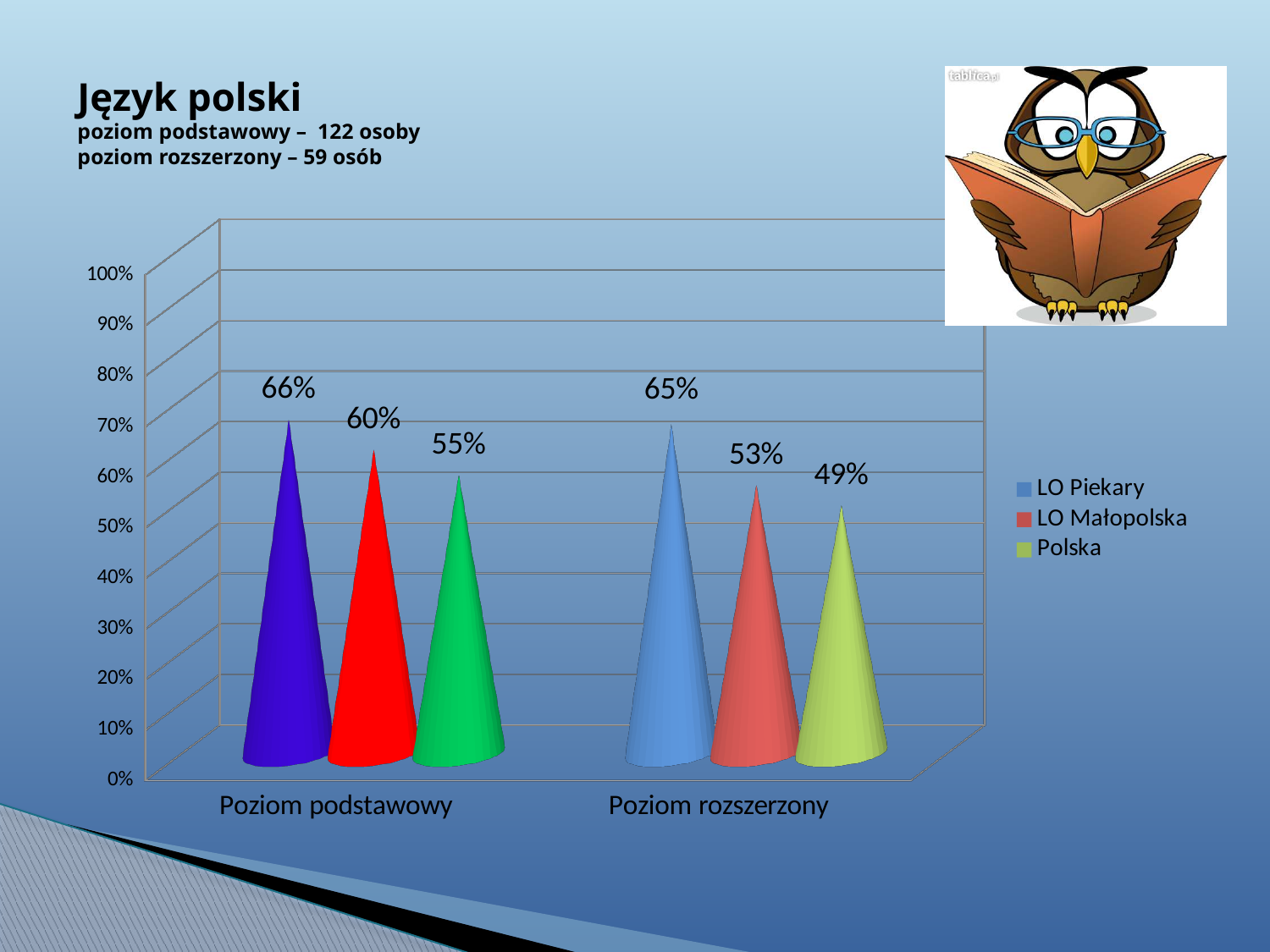
Which series has the highest value at Poziom podstawowy? LO Piekary How many series does the legend list? 3 What is the value for LO Piekary at Poziom podstawowy? 66% What kind of chart is shown on the slide? bar chart What is the difference between LO Piekary and Polska at Poziom podstawowy? 11% What is the difference between LO Piekary and LO Małopolska at Poziom rozszerzony? 12% Which series is shown in green in the legend? Polska Which is larger: LO Małopolska at Poziom podstawowy or LO Małopolska at Poziom rozszerzony? Poziom podstawowy Which series has the lowest value at Poziom rozszerzony? Polska What is the value for LO Małopolska at Poziom rozszerzony? 53% What is the value for Polska at Poziom rozszerzony? 49% How many categories are shown on the x axis? 2